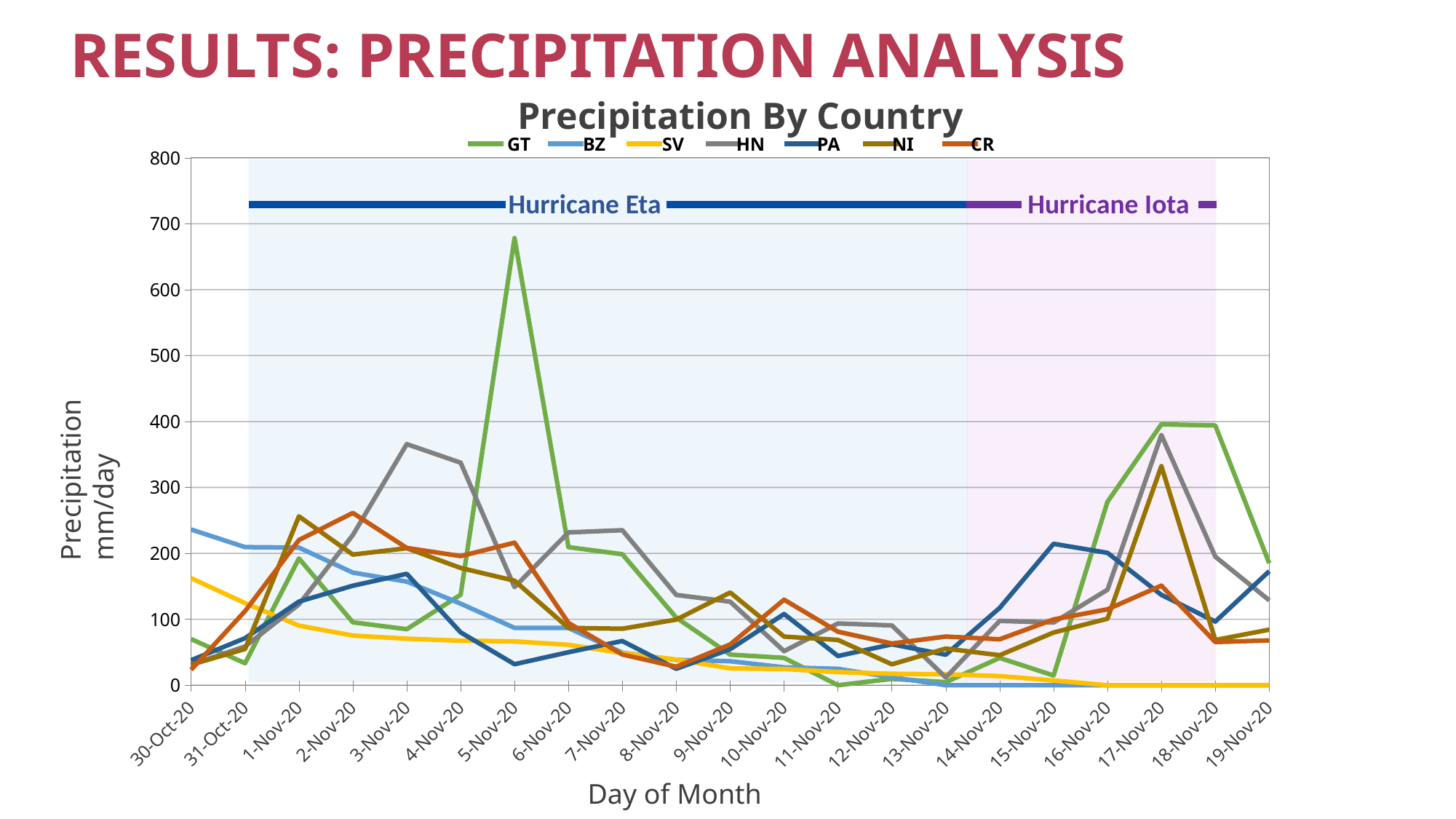
On 5-Nov-20, which series has the larger value, GT or HN? GT How many dates are shown along the x axis of the chart? 21 Is the value for GT on 5-Nov-20 greater or less than 600? greater Is the value for GT on 17-Nov-20 greater or less than 300? greater What is the title of the chart? Precipitation By Country What is the label of the x axis of the chart? Day of Month Is the value for SV on 19-Nov-20 greater or less than 100? less What kind of chart is shown on the slide? line chart Which series reaches the highest value anywhere on the chart? GT How many series does the legend of the Precipitation By Country chart list? 7